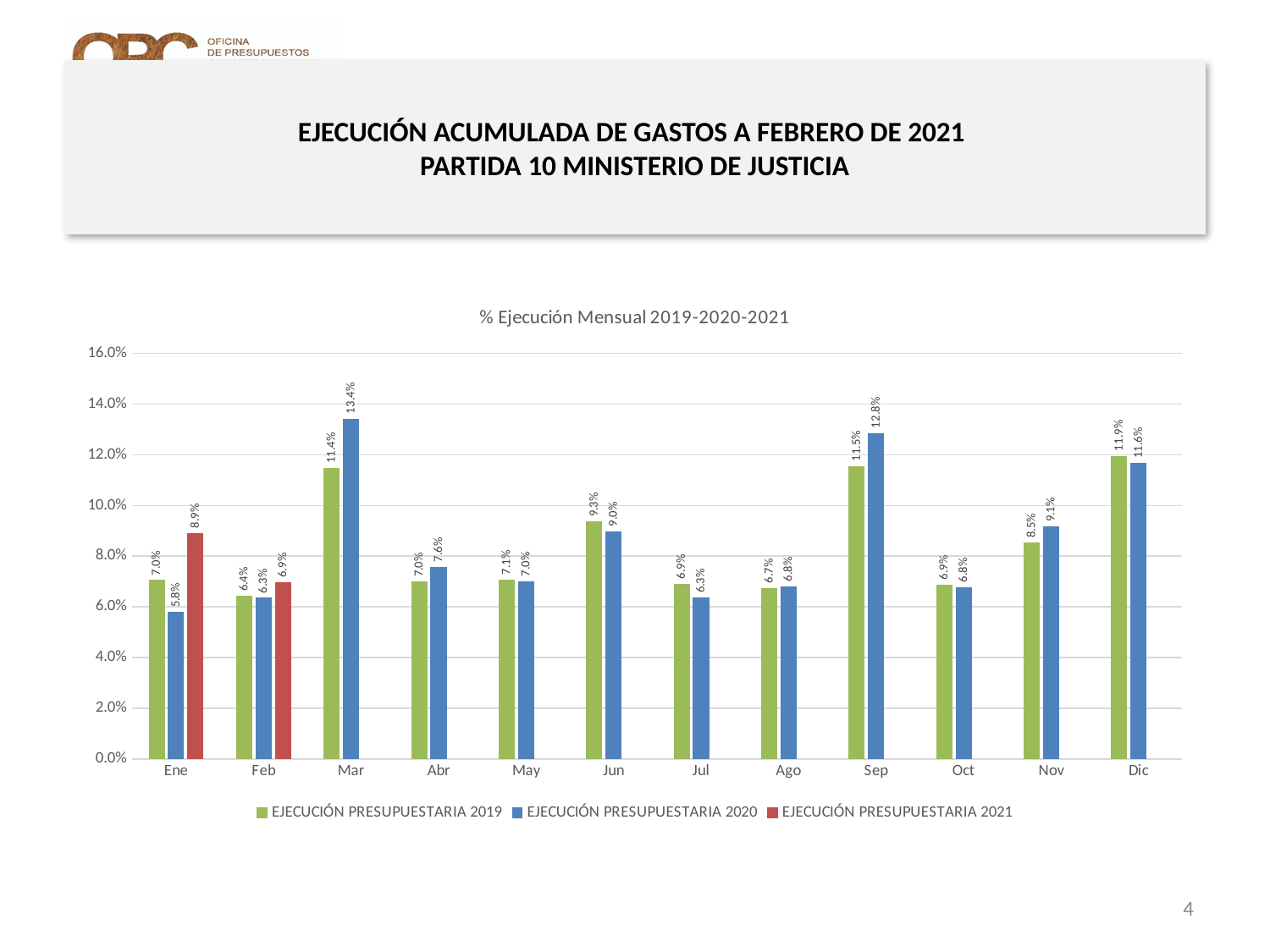
In which month is the EJECUCIÓN PRESUPUESTARIA 2020 value highest? Mar What is the title of the chart? % Ejecución Mensual 2019-2020-2021 Which is larger in Feb: EJECUCIÓN PRESUPUESTARIA 2019 or EJECUCIÓN PRESUPUESTARIA 2021? EJECUCIÓN PRESUPUESTARIA 2021 Is the value for EJECUCIÓN PRESUPUESTARIA 2019 in Dic greater or less than 10.0%? greater How many months are shown on the x axis? 12 How many series does the legend list? 3 What is the value for EJECUCIÓN PRESUPUESTARIA 2020 in Mar? 13.4% What is the value for EJECUCIÓN PRESUPUESTARIA 2021 in Ene? 8.9% What kind of chart is shown? Bar chart What is the value for EJECUCIÓN PRESUPUESTARIA 2019 in Sep? 11.5% What is the difference between the EJECUCIÓN PRESUPUESTARIA 2020 and EJECUCIÓN PRESUPUESTARIA 2019 values in Mar? 2.0% In which month is the EJECUCIÓN PRESUPUESTARIA 2020 value lowest? Ene